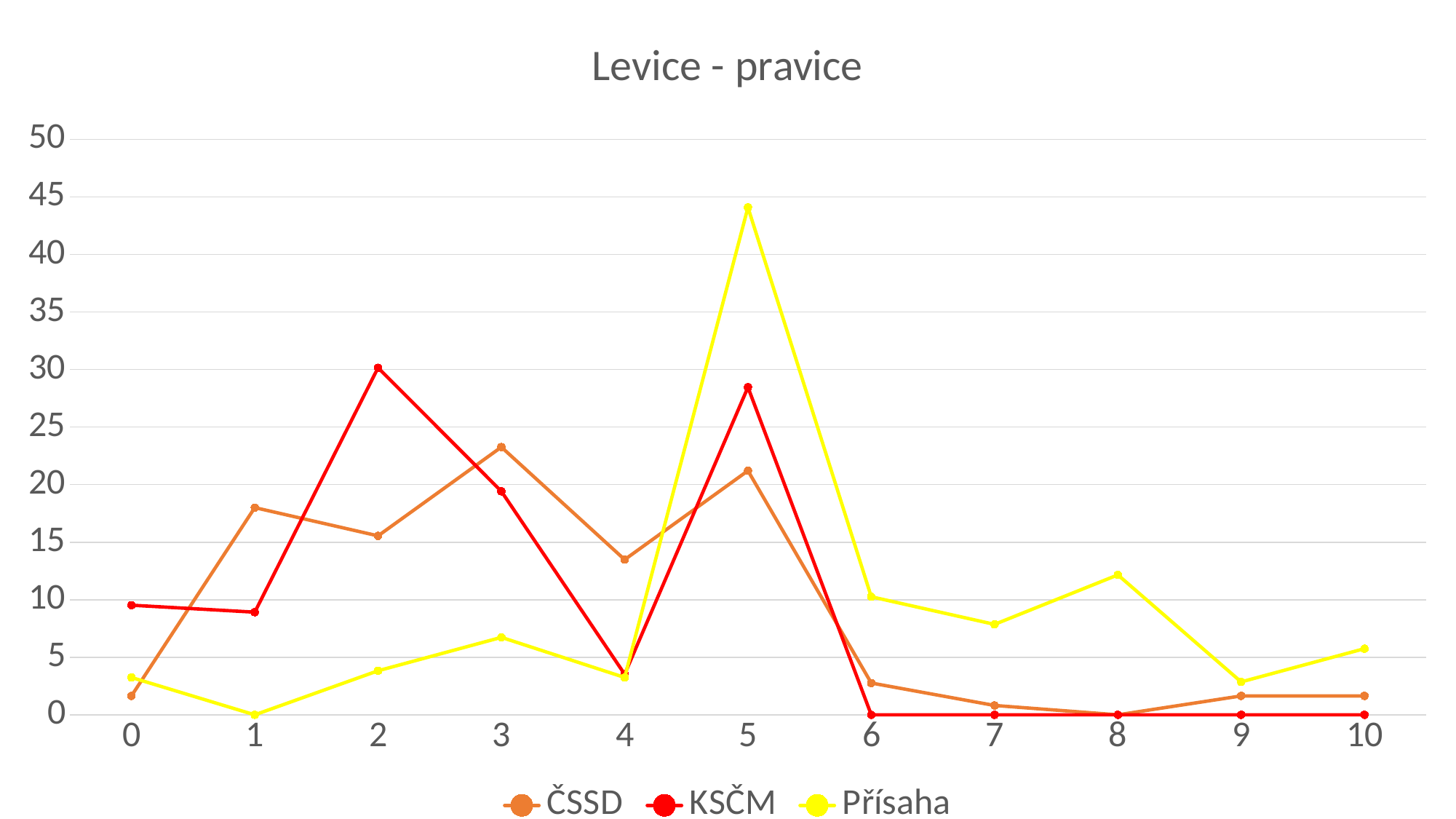
How many x-axis points are plotted for each series? 11 What kind of chart is shown on the slide? line chart At which x-axis value does the Přísaha series reach its highest point? 5 What is the value of KSČM at x = 10? 0 How many series does the legend list? 3 Is the value for ČSSD at x = 3 greater or less than 20? greater What is the title of the chart? Levice - pravice What is the value of Přísaha at x = 1? 0 At x = 5, which series has the higher value, KSČM or ČSSD? KSČM At which x-axis value does the ČSSD series reach its highest point? 3 Is the value for Přísaha at x = 5 greater or less than 40? greater At which x-axis value does the KSČM series reach its highest point? 2